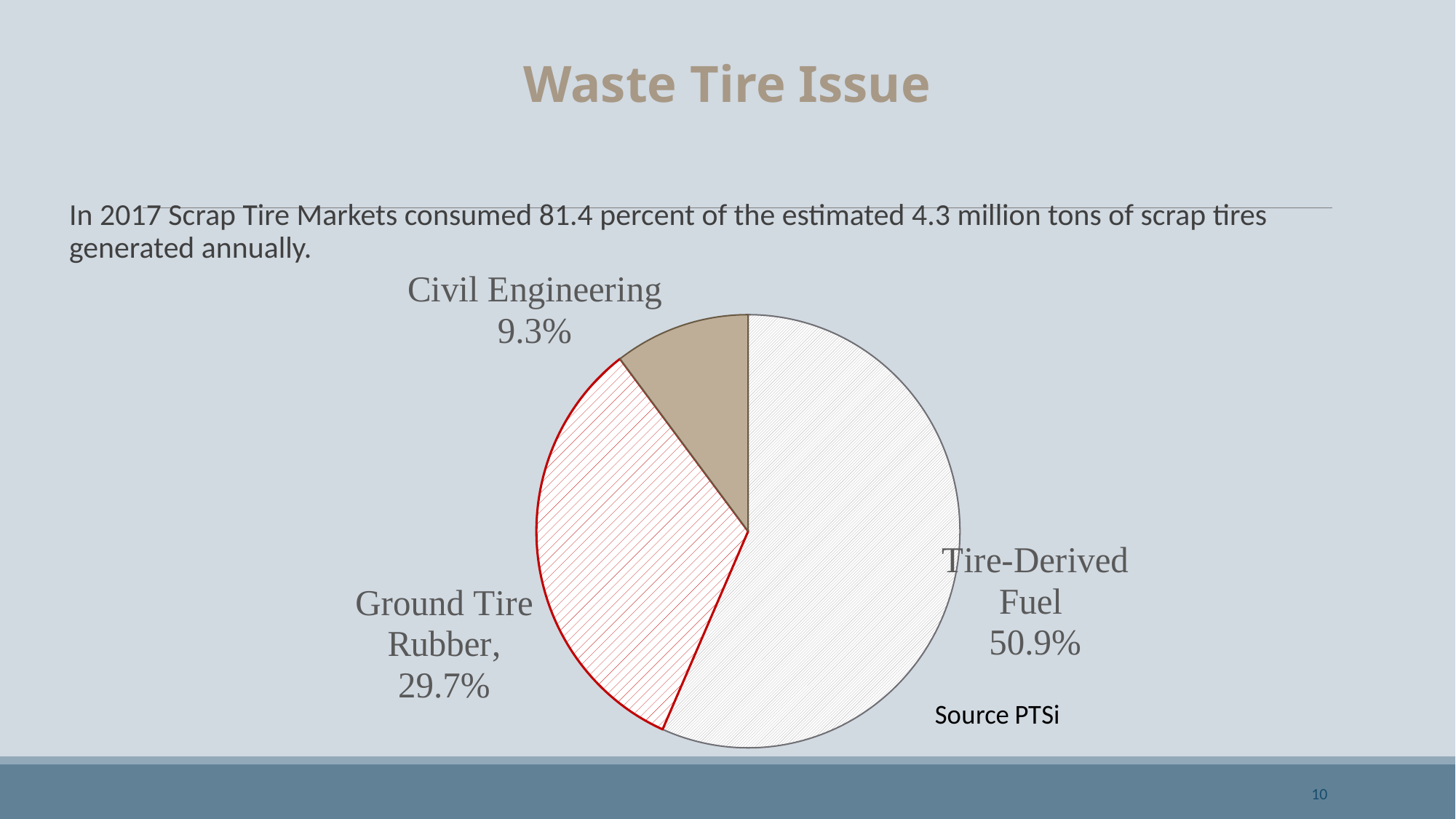
What is the difference in percentage points between Tire-Derived Fuel and Ground Tire Rubber? 21.2 What share of the pie does Tire-Derived Fuel account for? 50.9% Is the share for Tire-Derived Fuel greater or less than 50%? greater What source is cited for the pie chart? PTSi How many labelled slices does the pie chart have? 3 Which slice of the pie is the smallest? Civil Engineering What share of the pie does Ground Tire Rubber account for? 29.7% Which slice of the pie is the largest? Tire-Derived Fuel Which is larger, the Ground Tire Rubber slice or the Civil Engineering slice? Ground Tire Rubber What share of the pie does Civil Engineering account for? 9.3% What kind of chart is shown on the slide? Pie chart What is the difference in percentage points between Ground Tire Rubber and Civil Engineering? 20.4